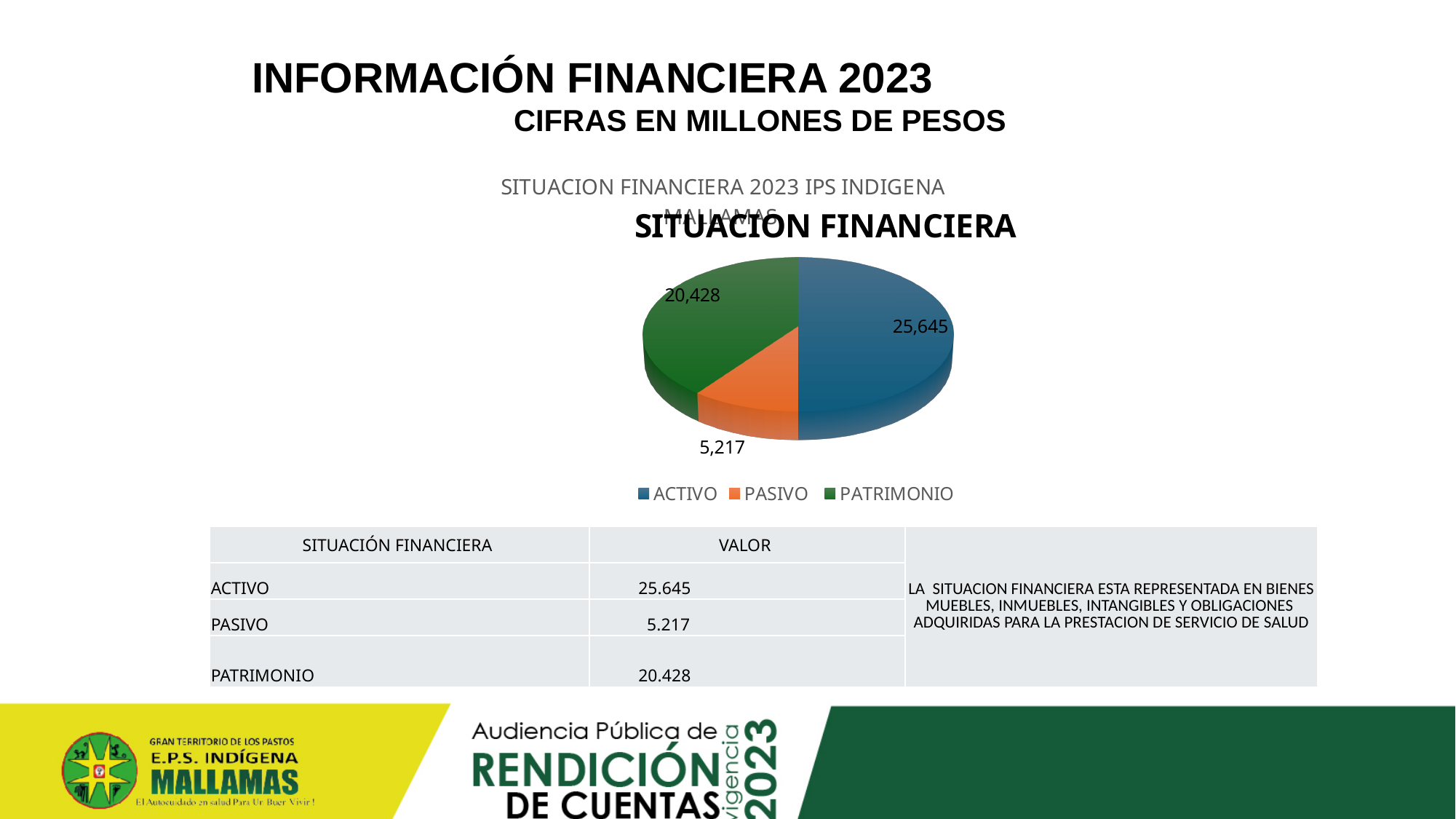
What is the difference between the values for PATRIMONIO and PASIVO? 15,211 Which is larger, the value for PATRIMONIO or the value for PASIVO? PATRIMONIO Which category has the smallest slice in the pie chart? PASIVO What is the value shown for ACTIVO in the pie chart? 25,645 What is the value shown for PATRIMONIO in the pie chart? 20,428 What kind of chart is shown on the slide? Pie chart What is the value shown for PASIVO in the pie chart? 5,217 How many slices does the pie chart have? 3 What colour is the PASIVO slice in the pie chart? Orange What is the difference between the values for ACTIVO and PATRIMONIO? 5,217 What share of the pie does ACTIVO represent? 50% Which category has the largest slice in the pie chart? ACTIVO